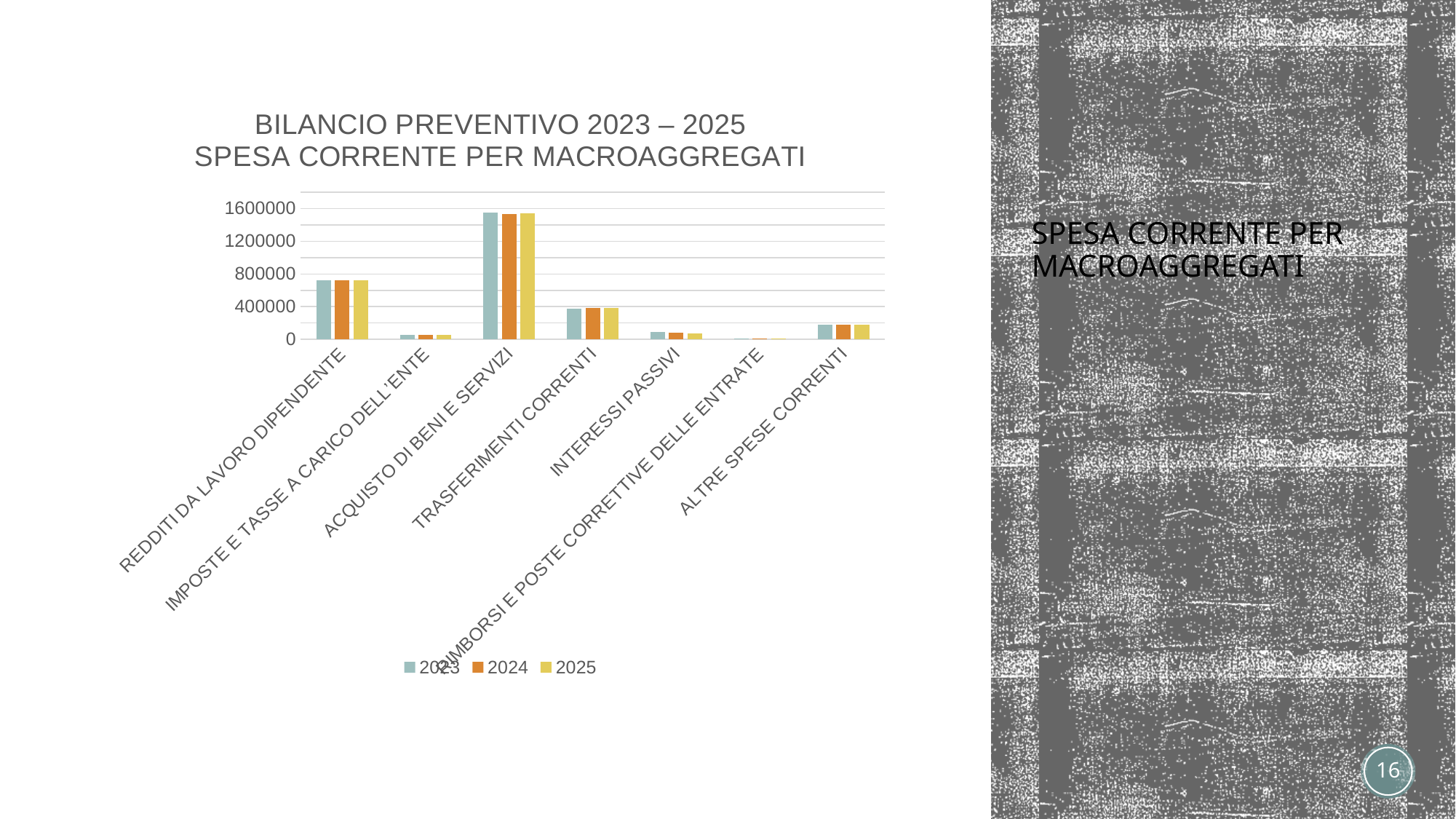
Which category has the highest values in the chart? ACQUISTO DI BENI E SERVIZI What kind of chart is shown on the slide? bar chart What is the title of the chart? BILANCIO PREVENTIVO 2023 – 2025 SPESA CORRENTE PER MACROAGGREGATI Which is larger in 2023: REDDITI DA LAVORO DIPENDENTE or TRASFERIMENTI CORRENTI? REDDITI DA LAVORO DIPENDENTE What are the series names listed in the chart legend? 2023, 2024, 2025 Which category has the lowest values in the chart? RIMBORSI E POSTE CORRETTIVE DELLE ENTRATE Is the 2023 value for ACQUISTO DI BENI E SERVIZI greater or less than 1200000? greater How many categories are shown on the x axis of the chart? 7 How many series does the chart legend list? 3 Is the 2023 value for REDDITI DA LAVORO DIPENDENTE greater or less than 800000? less Is the 2025 value for ALTRE SPESE CORRENTI greater or less than 400000? less